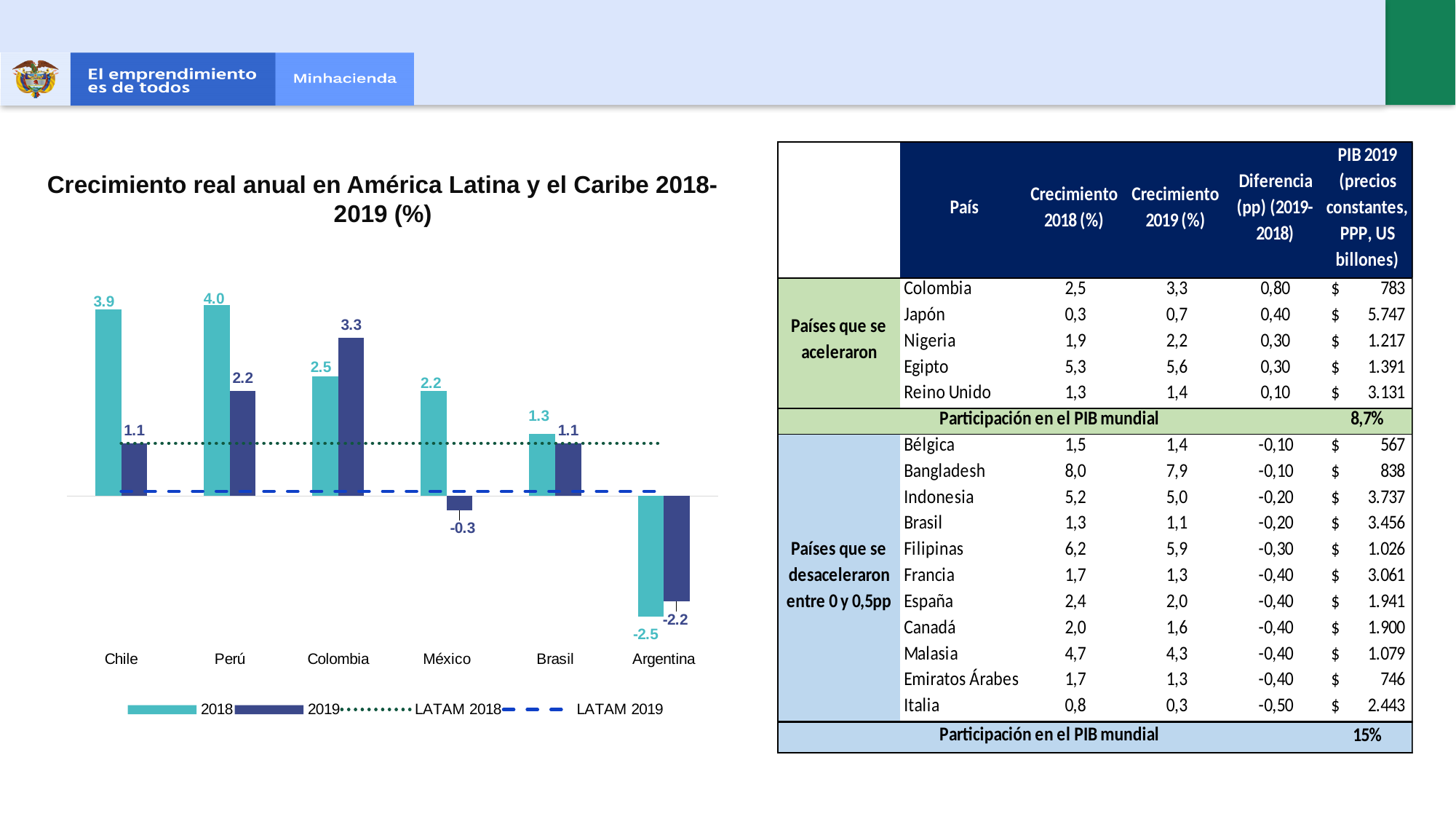
What is the difference between Colombia's 2019 and 2018 values in the chart? 0.8 How many countries are shown on the x axis of the chart? 6 What is the 2019 value for México in the chart? -0.3 How many entries does the chart's legend list? 4 What is the 2019 growth value for Colombia in the chart? 3.3 What type of chart is shown on the slide? combination bar and line chart Which is larger in the chart: Perú's 2019 value or Colombia's 2019 value? Colombia's 2019 value Does the 2018 series generally rise or fall from Chile to Argentina in the chart? fall Which country has the lowest 2018 value in the chart? Argentina Which country has the highest 2019 value in the chart? Colombia What is the 2018 growth value for Chile in the chart? 3.9 What is the title of the chart? Crecimiento real anual en América Latina y el Caribe 2018-2019 (%)